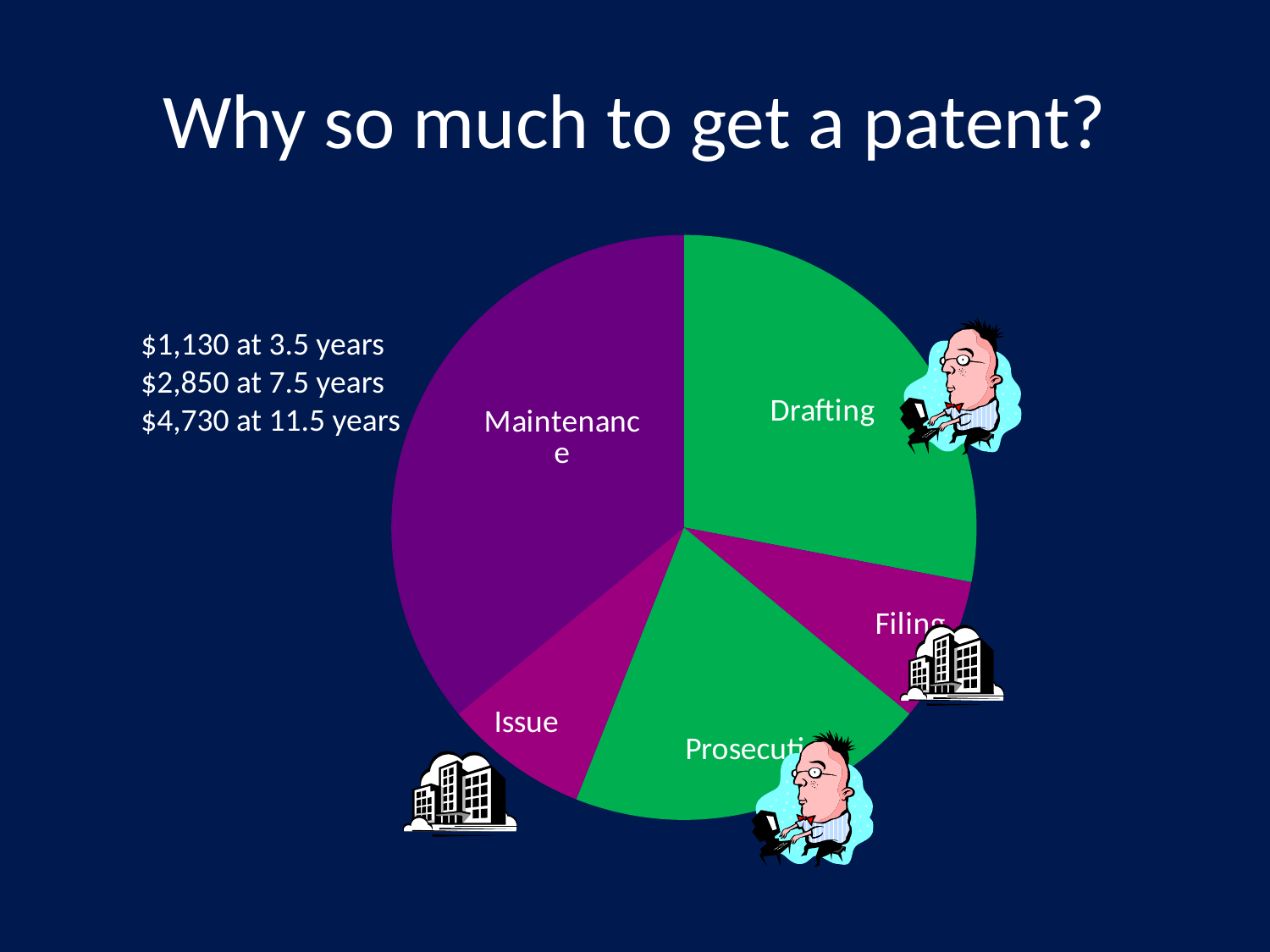
Which slice is larger, Drafting or Prosecution? Drafting Which slice of the pie chart is the largest? Maintenance How many slices does the pie chart have? 5 What kind of chart is shown on the slide? pie chart What colour is the Drafting slice of the pie chart? green What is the title of the slide containing the pie chart? Why so much to get a patent? Which slice is larger, Maintenance or Filing? Maintenance Which slice is larger, Drafting or Filing? Drafting